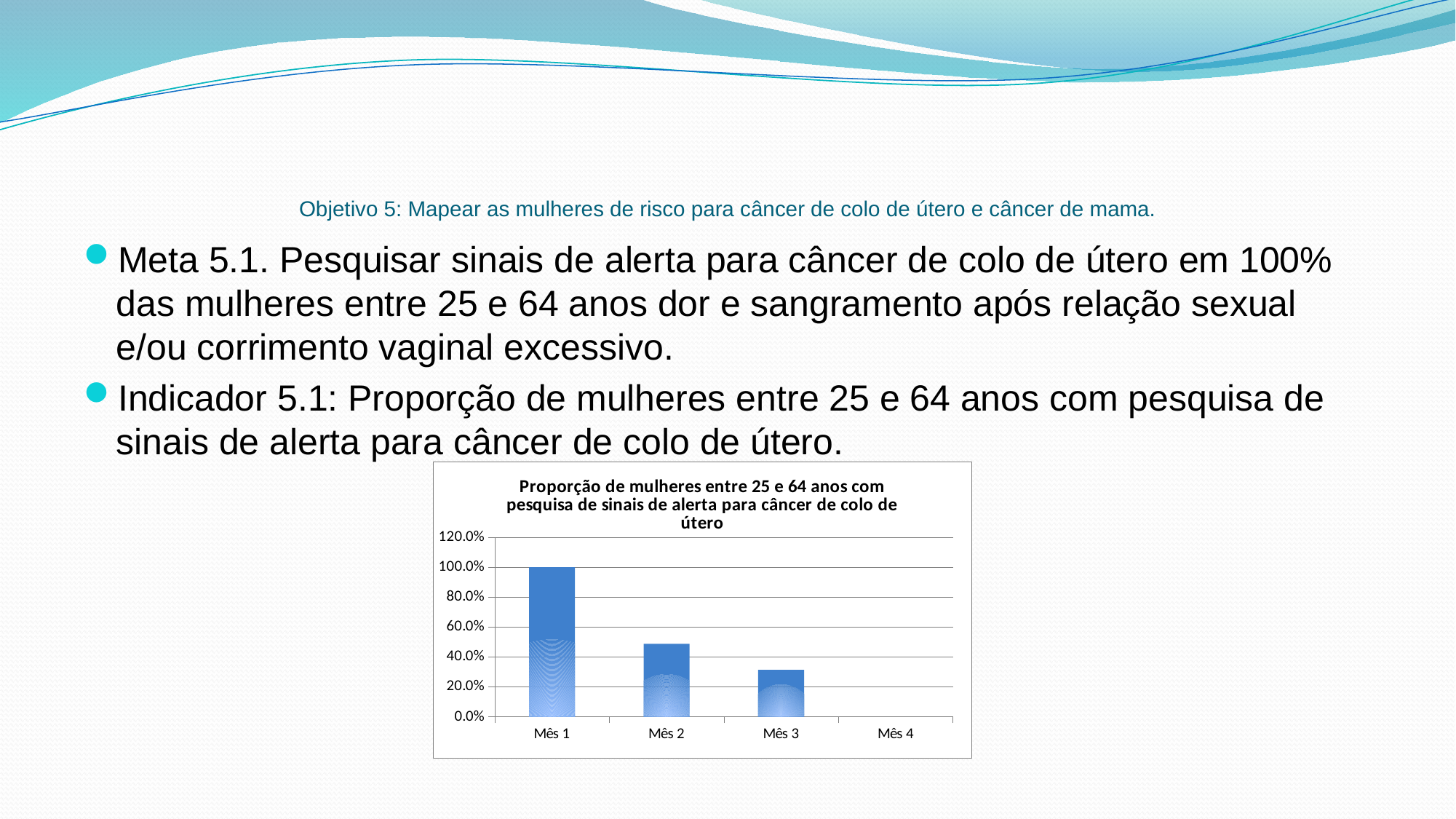
What is the title of the chart? Proporção de mulheres entre 25 e 64 anos com pesquisa de sinais de alerta para câncer de colo de útero What kind of chart is shown on the slide? bar chart How many categories are shown on the x axis of the chart? 4 Which is larger, the value for Mês 2 or the value for Mês 3? Mês 2 Is the value for Mês 3 greater or less than 40.0%? less Do the values rise or fall from Mês 1 to Mês 3? fall Is the value for Mês 3 greater or less than 20.0%? greater What is the highest value shown on the y axis of the chart? 120.0% Is the value for Mês 2 greater or less than 40.0%? greater What is the value for Mês 1 in the chart? 100.0% Which month has the highest value in the chart? Mês 1